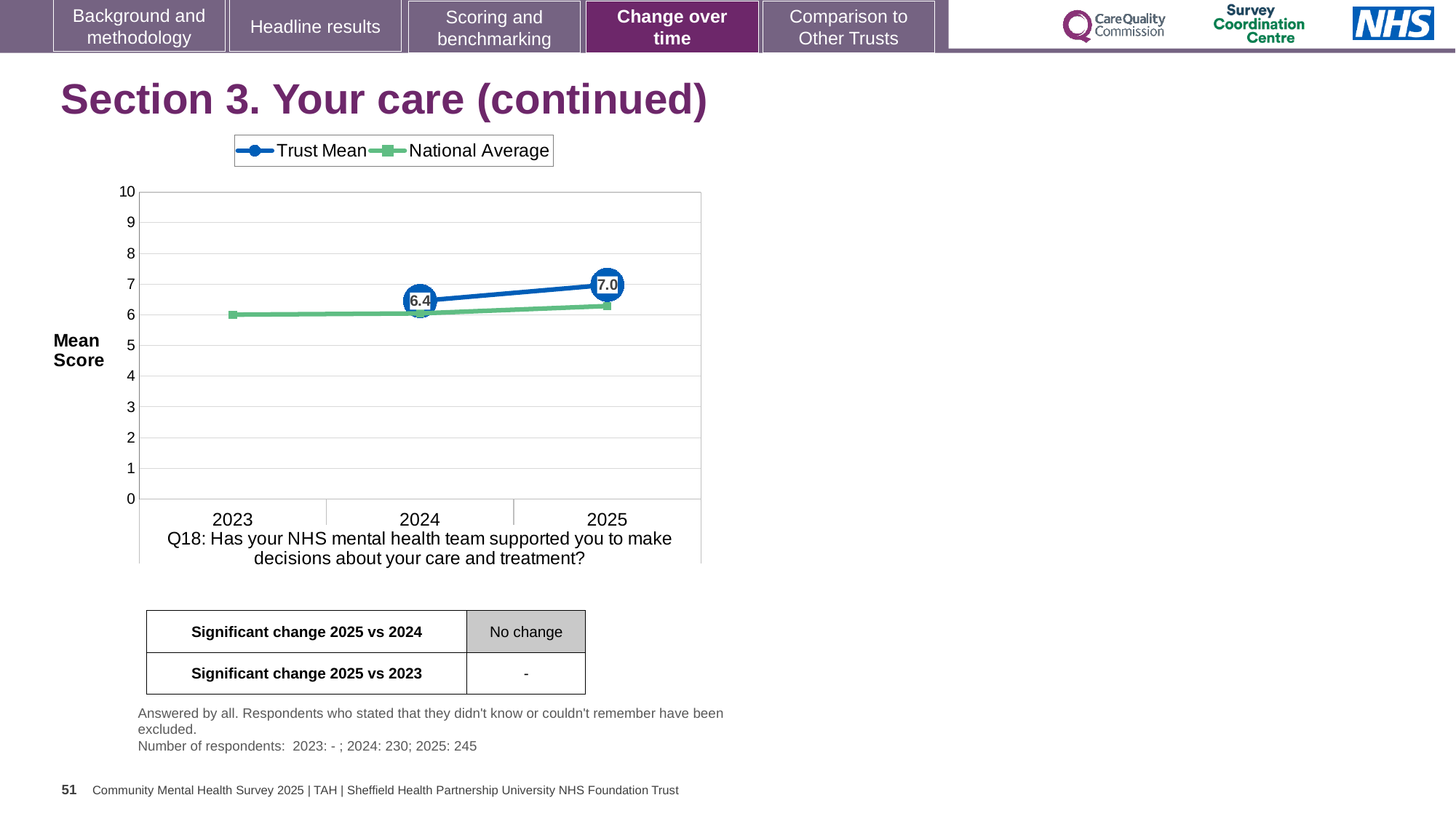
What kind of chart is shown on the slide? line chart Is the National Average value for 2025 greater or less than 5? greater By how much did the Trust Mean change from 2024 to 2025? 0.6 What is the label on the y axis of the chart? Mean Score What is the Trust Mean value for 2024? 6.4 Is the National Average value for 2023 greater or less than 7? less What is the Trust Mean value for 2025? 7.0 How many series does the legend list? 2 How many years are shown on the x axis? 3 Does the Trust Mean rise or fall from 2024 to 2025? rise In 2025, which is larger: the Trust Mean or the National Average? Trust Mean Which year has the highest Trust Mean? 2025